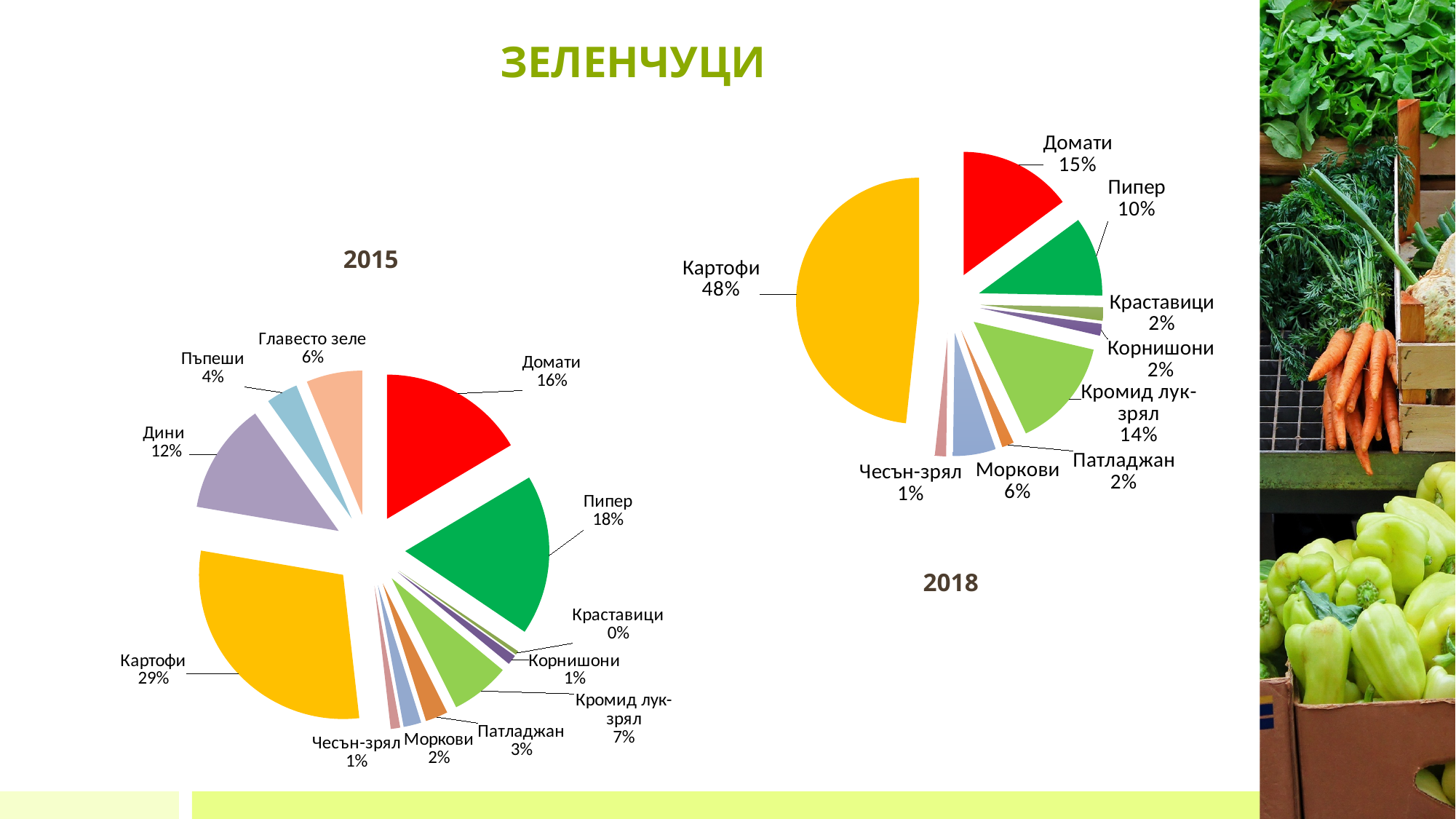
In the 2015 pie chart, which category has the smallest share? Краставици In the 2018 pie chart, which category has the smallest share? Чесън-зрял In the 2018 pie chart, what share do Картофи have? 48% How many categories does the 2018 pie chart show? 9 In the 2015 pie chart, what share do Картофи have? 29% What is the difference between the Картофи share in the 2018 chart and the Картофи share in the 2015 chart? 19% What type of chart is used for the 2015 data? Pie chart In the 2015 pie chart, what is the share for Пипер? 18% In the 2015 pie chart, which category has the largest share? Картофи In the 2018 pie chart, what is the share for Кромид лук-зрял? 14% How many categories does the 2015 pie chart show? 12 In the 2018 pie chart, which is larger: Домати or Пипер? Домати